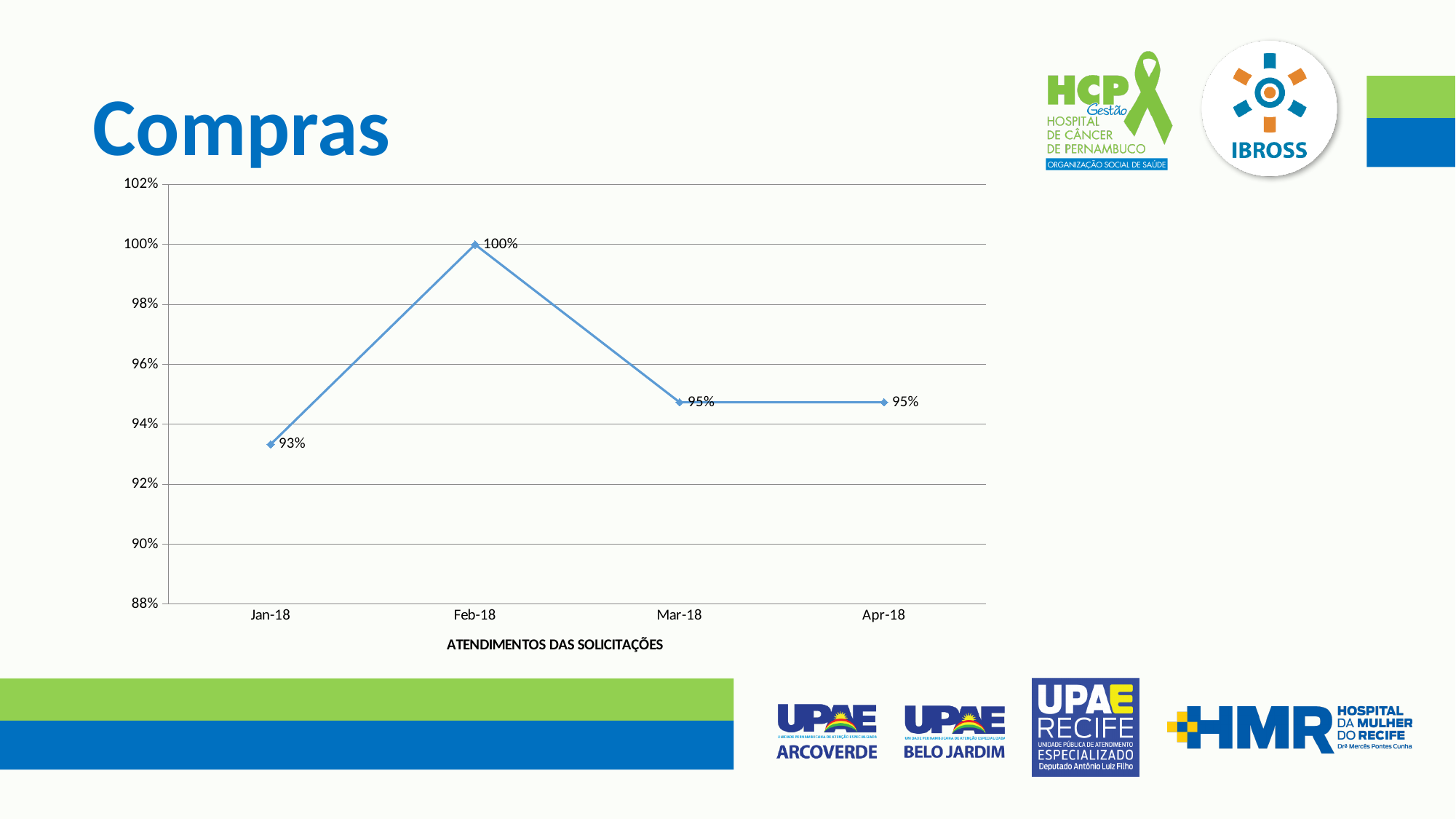
How many months are plotted on the x axis? 4 What is the value for Mar-18? 95% Is the value for Jan-18 greater or less than 94%? less Which month has the lowest value? Jan-18 Which month has the highest value? Feb-18 What is the value for Feb-18? 100% What is the difference between the values for Feb-18 and Jan-18? 7% What kind of chart is shown on the slide? line chart What is the value for Apr-18? 95% What is the label shown below the x axis of the chart? ATENDIMENTOS DAS SOLICITAÇÕES Which is larger, the value for Feb-18 or the value for Mar-18? Feb-18 What is the value for Jan-18? 93%